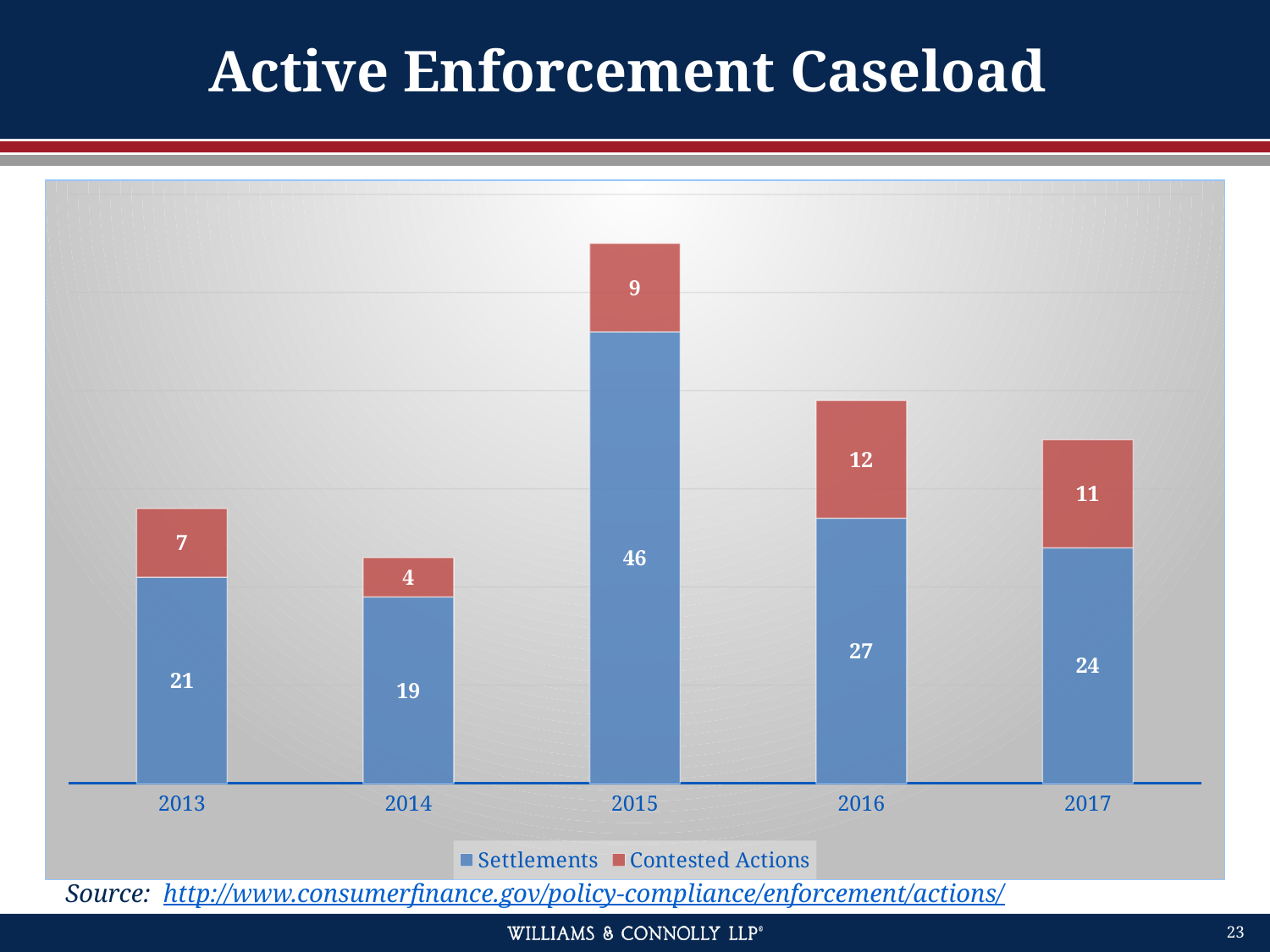
What is the total of the stacked bar for 2015? 55 What is the value for Settlements in 2015? 46 What kind of chart is shown on the slide? Stacked bar chart How many years are shown on the x axis? 5 What is the value for Contested Actions in 2016? 12 What is the difference between Settlements in 2016 and Settlements in 2017? 3 Which year has the lowest value for Contested Actions? 2014 Which is larger: Contested Actions in 2013 or Contested Actions in 2017? Contested Actions in 2017 What is the value for Settlements in 2014? 19 What is the total of the stacked bar for 2013? 28 Which year has the highest value for Settlements? 2015 How many series does the legend list? 2